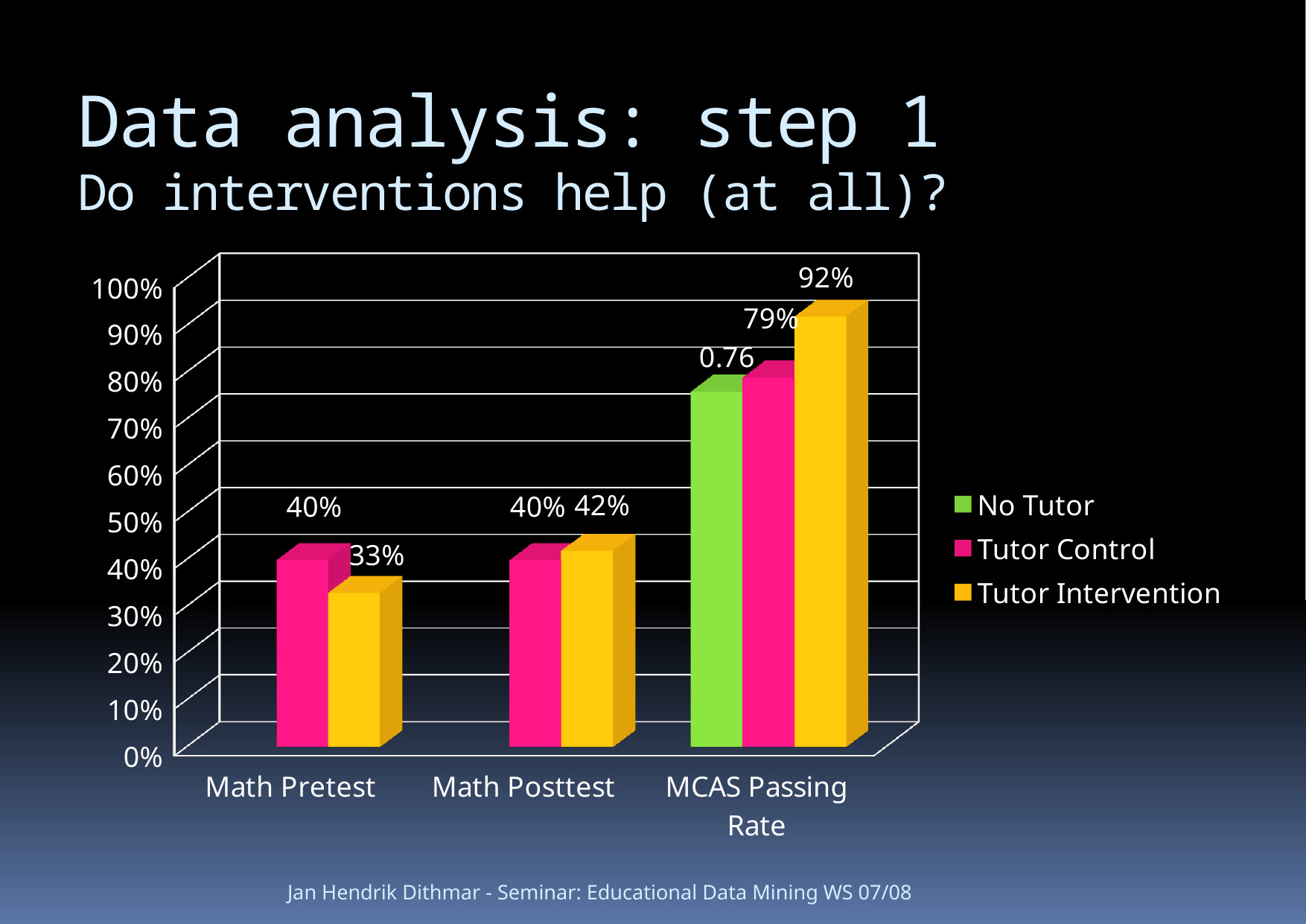
How many categories are shown on the x axis? 3 Does the Tutor Intervention series rise or fall from Math Pretest to MCAS Passing Rate? Rise Which series has the lowest value in the Math Pretest category? Tutor Intervention In the Math Pretest category, which is larger: Tutor Control or Tutor Intervention? Tutor Control What is the difference between Tutor Intervention and Tutor Control in the MCAS Passing Rate category? 13% What is the value for Tutor Intervention in the Math Pretest category? 33% What is the value for Tutor Control in the Math Posttest category? 40% Which series has the highest value in the MCAS Passing Rate category? Tutor Intervention What is the value for Tutor Intervention in the MCAS Passing Rate category? 92% What kind of chart is shown on the slide? Bar chart How many series does the legend list? 3 What data label is shown for No Tutor in the MCAS Passing Rate category? 0.76